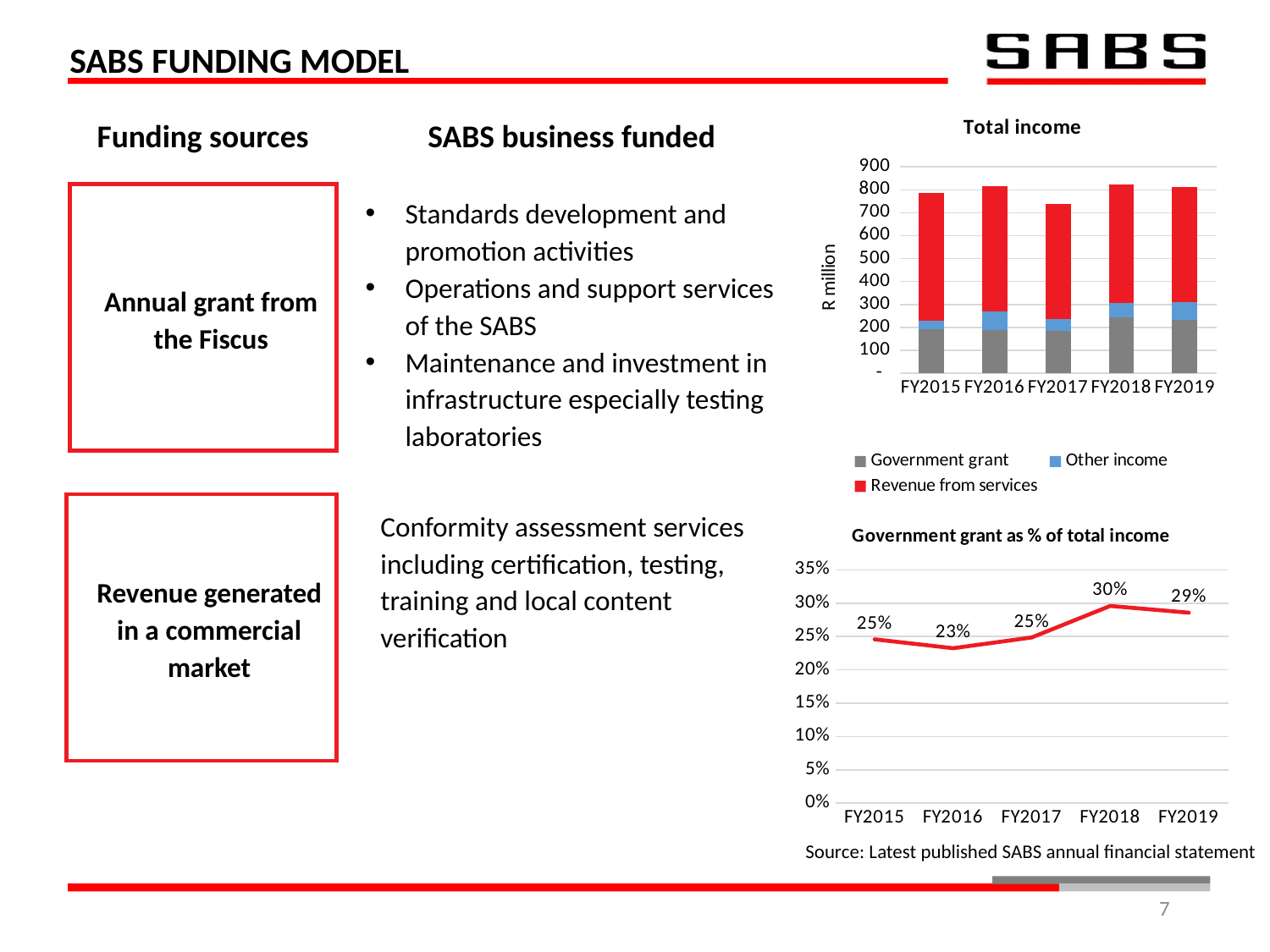
In the 'Government grant as % of total income' chart, what is the difference between the FY2018 and FY2016 values? 7 percentage points In the 'Government grant as % of total income' chart, what is the value for FY2018? 30% In the 'Total income' chart, which year has the lowest total income? FY2017 In the 'Government grant as % of total income' chart, how many years are plotted? 5 In the 'Government grant as % of total income' chart, which year has the highest value? FY2018 In the 'Total income' chart, is the total income for FY2017 greater or less than 800? less What kind of chart is the 'Total income' chart? Stacked bar chart In the 'Government grant as % of total income' chart, what is the value for FY2016? 23% In the 'Government grant as % of total income' chart, which is larger, the value for FY2019 or the value for FY2017? FY2019 How many series does the legend of the 'Total income' chart list? 3 What kind of chart is the 'Government grant as % of total income' chart? Line chart In the 'Government grant as % of total income' chart, which year has the lowest value? FY2016